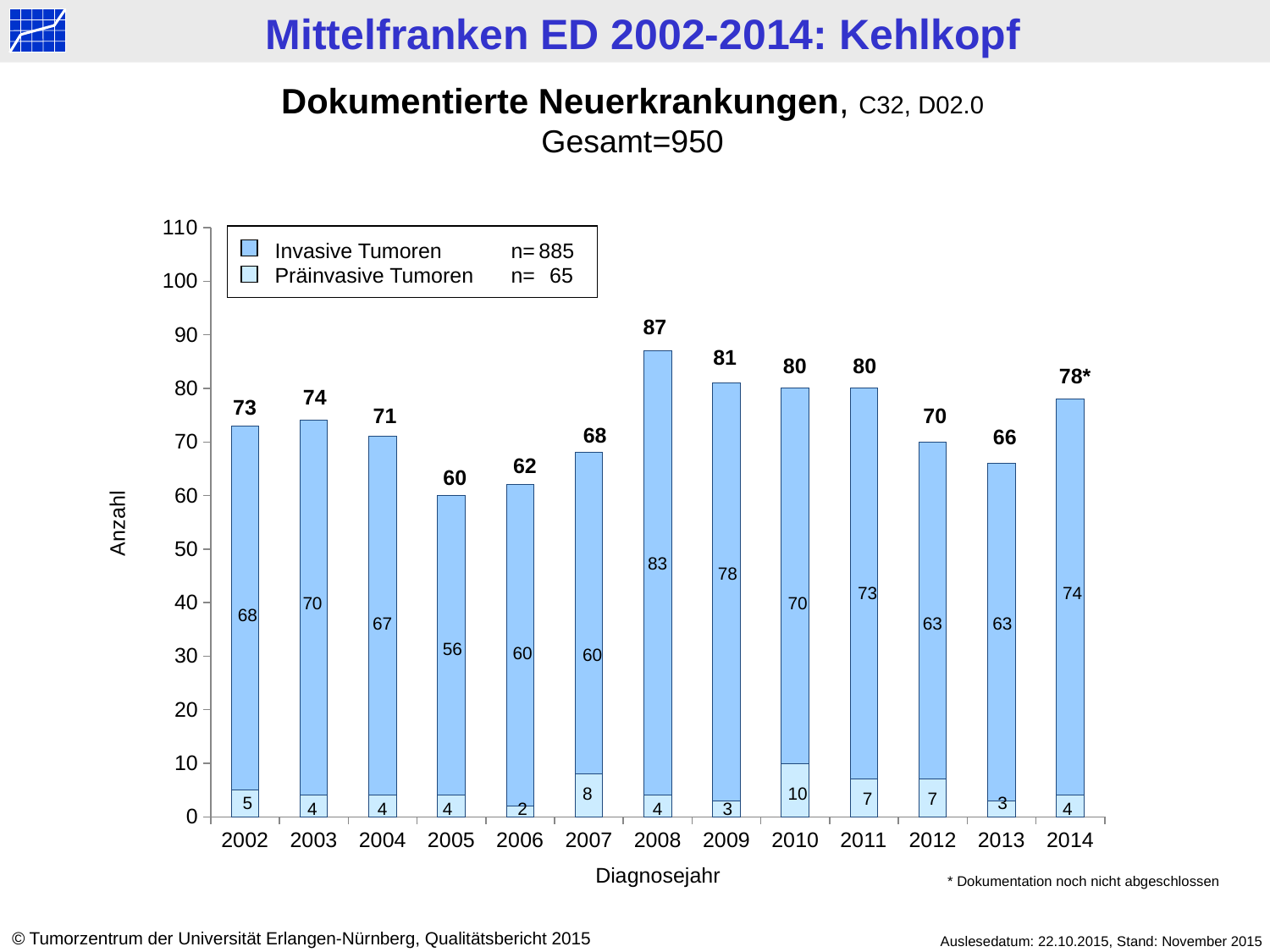
What kind of chart is shown on the slide? Stacked bar chart Which diagnosis year has the highest total number of documented new cases? 2008 How many diagnosis years are shown on the x axis? 13 What is the number of pre-invasive tumours (Präinvasive Tumoren) in 2010? 10 What is the n value given in the legend for Invasive Tumoren? 885 What is the difference between the total for 2008 and the total for 2013? 21 Which year has more invasive tumours, 2009 or 2012? 2009 How many series does the legend list? 2 What is the label of the y axis? Anzahl Which diagnosis year has the lowest total number of documented new cases? 2005 What is the number of invasive tumours (Invasive Tumoren) in 2008? 83 What is the total height of the stacked bar for 2011? 80